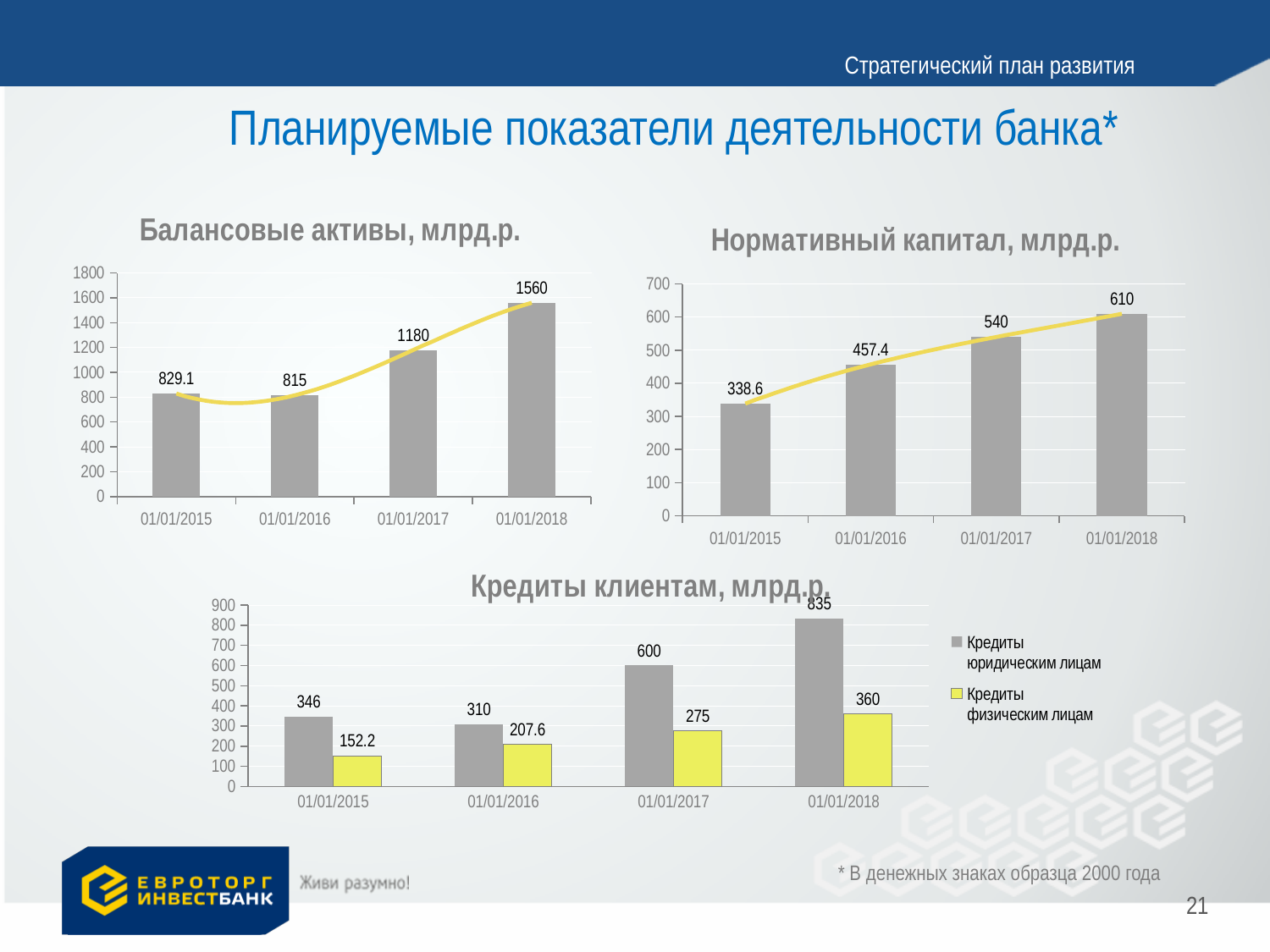
What kind of chart is 'Кредиты клиентам, млрд.р.'? bar chart In the chart 'Нормативный капитал, млрд.р.', how many dates are shown on the x axis? 4 In the chart 'Нормативный капитал, млрд.р.', what is the value for 01/01/2016? 457.4 In the chart 'Кредиты клиентам, млрд.р.', which is larger for 01/01/2017: 'Кредиты юридическим лицам' or 'Кредиты физическим лицам'? Кредиты юридическим лицам In the chart 'Кредиты клиентам, млрд.р.', what is the value of 'Кредиты юридическим лицам' for 01/01/2018? 835 In the chart 'Кредиты клиентам, млрд.р.', how many series does the legend list? 2 In the chart 'Балансовые активы, млрд.р.', what is the value for 01/01/2017? 1180 In the chart 'Балансовые активы, млрд.р.', what is the difference between the values for 01/01/2018 and 01/01/2017? 380 In the chart 'Балансовые активы, млрд.р.', which date has the lowest value? 01/01/2016 In the chart 'Нормативный капитал, млрд.р.', which date has the highest value? 01/01/2018 In the chart 'Кредиты клиентам, млрд.р.', what is the value of 'Кредиты физическим лицам' for 01/01/2016? 207.6 In the chart 'Нормативный капитал, млрд.р.', do the values rise or fall from 01/01/2015 to 01/01/2018? rise